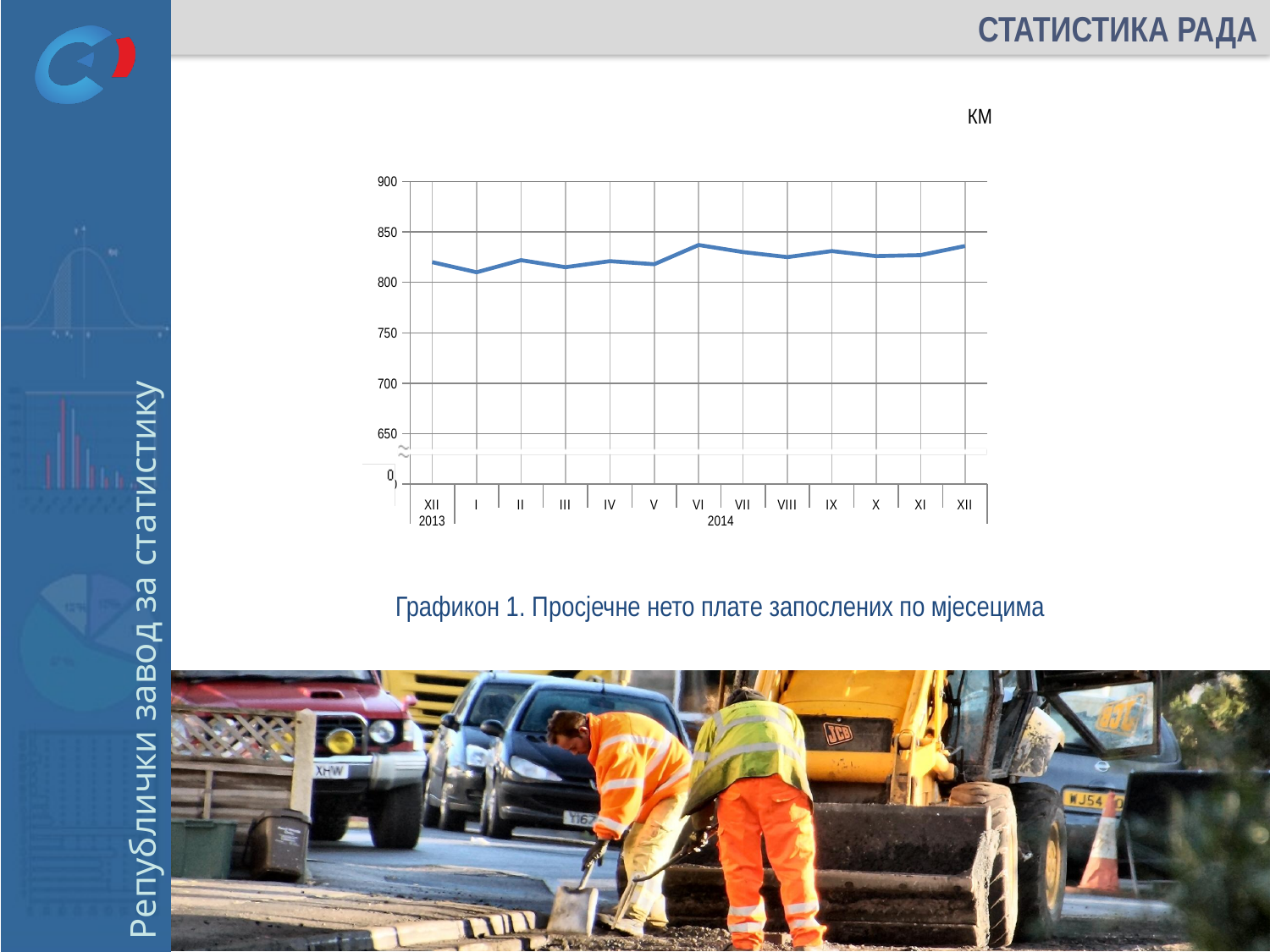
Does the value rise or fall from V 2014 to VI 2014? rise Which is larger, the value for VI 2014 or the value for I 2014? VI 2014 What is the caption of the chart? Графикон 1. Просјечне нето плате запослених по мјесецима Which month has the lowest value on the chart? I 2014 Is the value for XII 2013 greater or less than 850? less Which is larger, the value for XII 2014 or the value for III 2014? XII 2014 What unit is indicated above the chart? KM Is the value for VI 2014 greater or less than 800? greater How many monthly data points are plotted on the chart? 13 Is the value for XII 2014 greater or less than 800? greater What kind of chart is shown on the slide? line chart